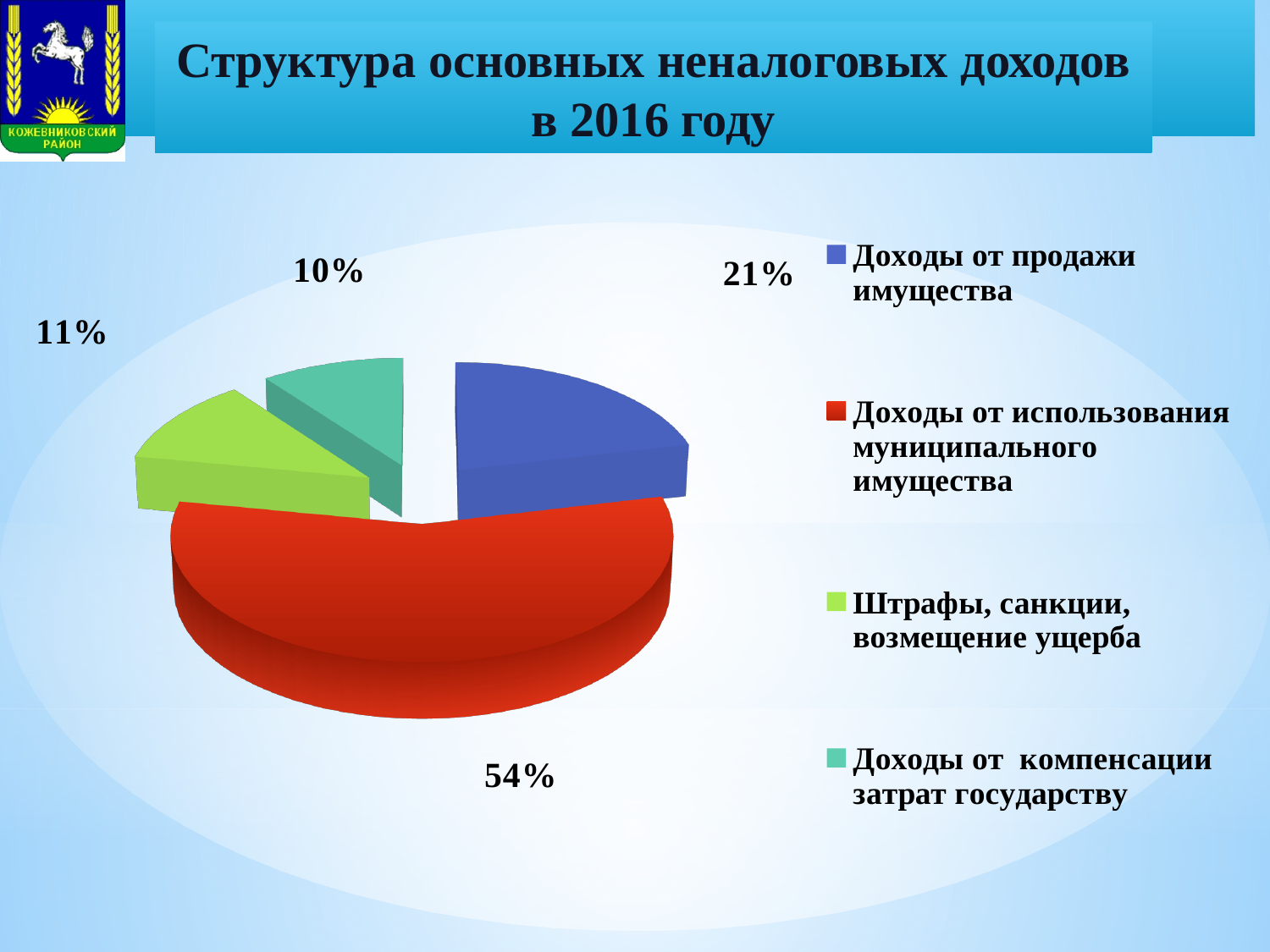
Which category has the largest slice of the pie? Доходы от использования муниципального имущества What share of the pie is "Штрафы, санкции, возмещение ущерба"? 11% What share of the pie is "Доходы от компенсации затрат государству"? 10% Which category has the smallest slice of the pie? Доходы от компенсации затрат государству How many slices does the pie chart have? 4 What colour is the slice for "Доходы от использования муниципального имущества"? red What kind of chart is shown on the slide? pie chart What share of the pie is "Доходы от продажи имущества"? 21% Which is larger: "Штрафы, санкции, возмещение ущерба" or "Доходы от компенсации затрат государству"? Штрафы, санкции, возмещение ущерба What is the title of the chart on the slide? Структура основных неналоговых доходов в 2016 году What share of the pie is "Доходы от использования муниципального имущества"? 54% What is the difference in percentage points between "Доходы от использования муниципального имущества" and "Доходы от продажи имущества"? 33